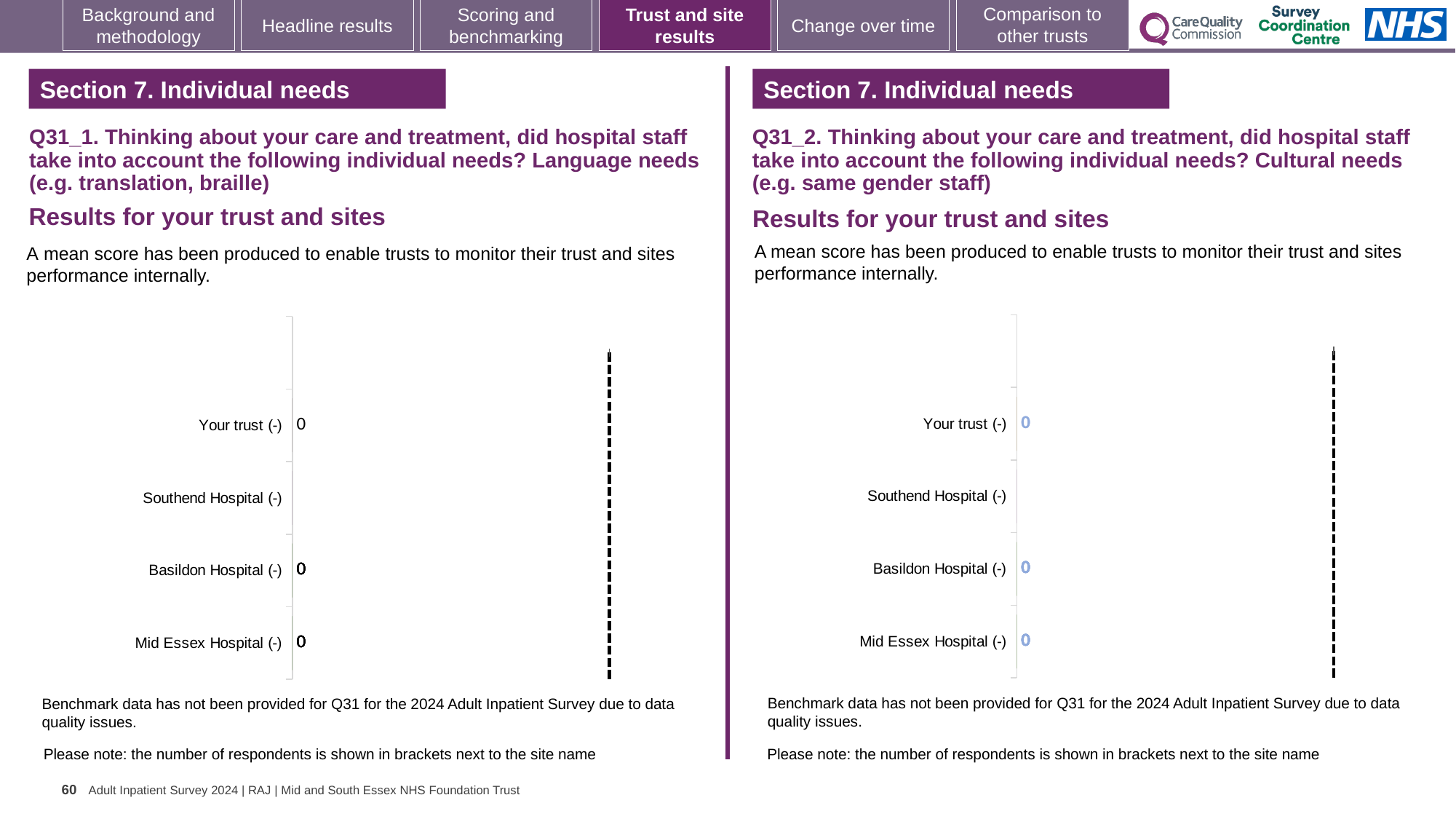
What kind of chart is used on the left side of the slide for Q31_1? Bar chart In the left chart (Q31_1, Language needs), how many categories are listed on the vertical axis? 4 In the left chart (Q31_1, Language needs), which category appears at the bottom of the vertical axis? Mid Essex Hospital (-) In the left chart (Q31_1, Language needs), what value is shown for Your trust (-)? 0 In the left chart (Q31_1, Language needs), what value is shown for Mid Essex Hospital (-)? 0 In the right chart (Q31_2, Cultural needs), which category appears at the top of the vertical axis? Your trust (-) In the right chart (Q31_2, Cultural needs), what value is shown for Your trust (-)? 0 In the right chart (Q31_2, Cultural needs), what value is shown for Mid Essex Hospital (-)? 0 In the right chart (Q31_2, Cultural needs), what value is shown for Basildon Hospital (-)? 0 In the right chart (Q31_2, Cultural needs), how many categories are listed on the vertical axis? 4 In the left chart (Q31_1, Language needs), what value is shown for Basildon Hospital (-)? 0